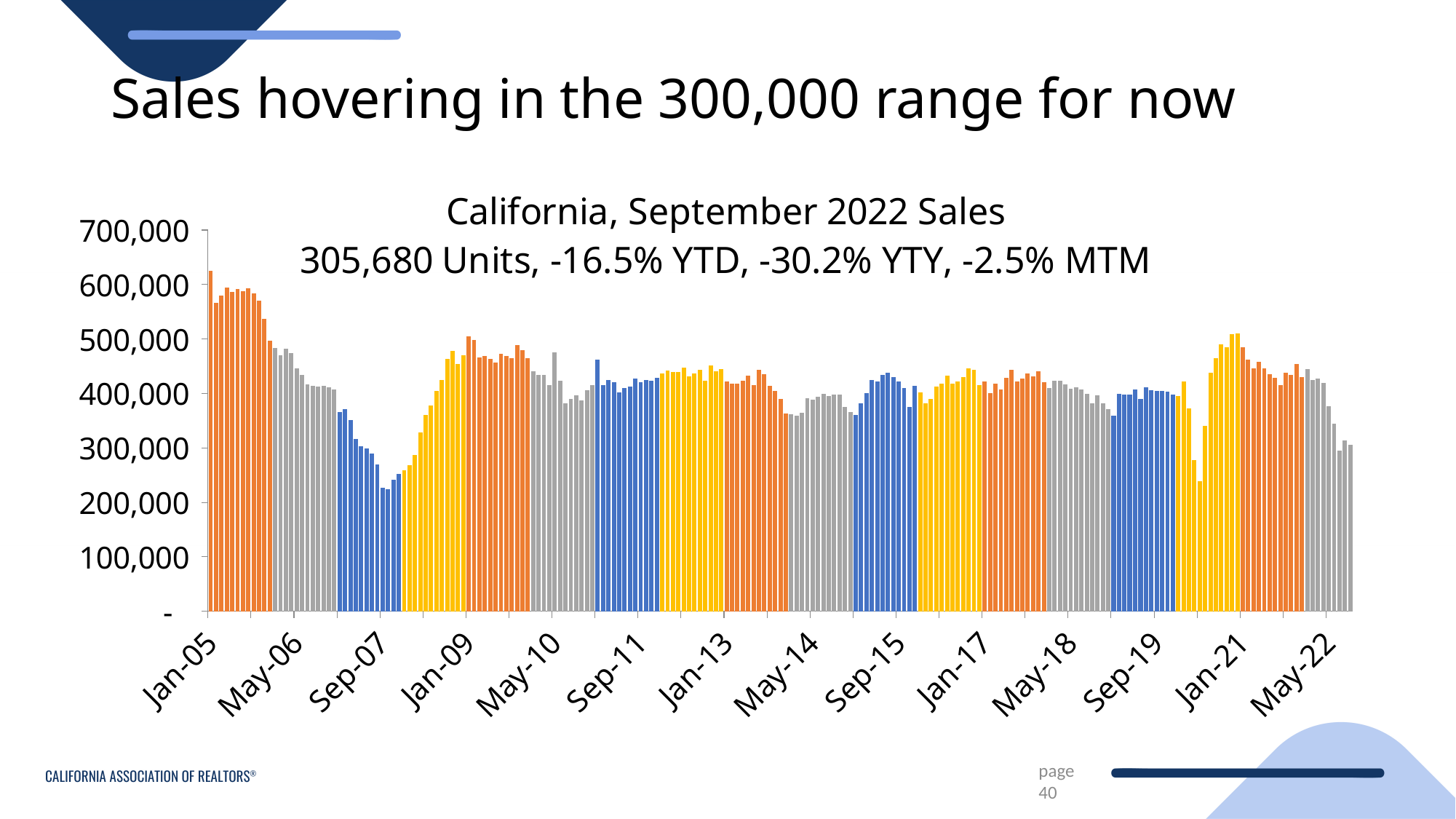
Which x-axis label is closest to the tallest bar in the chart? Jan-05 Do sales rise or fall between Jan-05 and Sep-07? fall What is the highest value shown on the vertical axis? 700,000 Is the value for Jan-05 larger or smaller than the value for Jan-09? larger According to the chart title, how many units were sold in California in September 2022? 305,680 Units Is the lowest bar in the chart, which falls between Sep-07 and Jan-09, greater or less than 300,000? less Is the value for Jan-21 greater or less than 400,000? greater Do sales rise or fall between Sep-07 and Jan-09? rise What kind of chart is shown on the slide? bar chart What is the year-to-date (YTD) percentage change stated in the chart title? -16.5% Is the value for Jan-05 greater or less than 600,000? greater What is the year-to-year (YTY) percentage change stated in the chart title? -30.2%